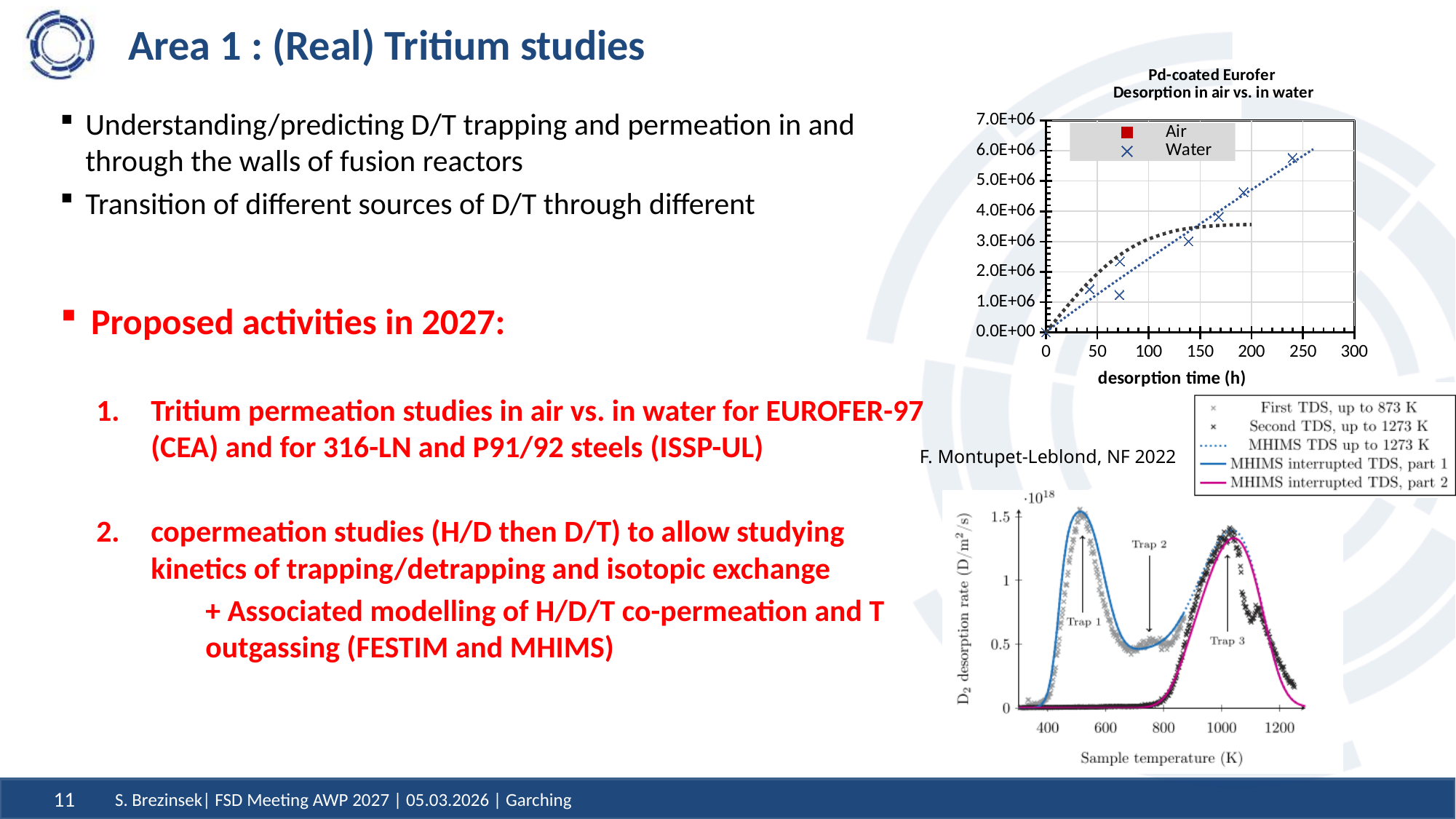
In the 'Pd-coated Eurofer Desorption in air vs. in water' chart, what is the label of the x axis? desorption time (h) In the bottom-right TDS chart, is the peak desorption rate at Trap 1 greater or less than 1 (×10^18 D/m²/s)? greater In the 'Pd-coated Eurofer Desorption in air vs. in water' chart, is the Water value at about 70 h greater or less than 2.0E+06? less In the 'Pd-coated Eurofer Desorption in air vs. in water' chart, what are the two series named in the legend? Air and Water In the 'Pd-coated Eurofer Desorption in air vs. in water' chart, around 50 h, which series shows the higher value, Air or Water? Air In the 'Pd-coated Eurofer Desorption in air vs. in water' chart, is the Water value at about 240 h greater or less than 5.0E+06? greater In the 'Pd-coated Eurofer Desorption in air vs. in water' chart, how many series does the legend list? 2 In the bottom-right TDS chart, which peak is higher, Trap 1 or Trap 3? Trap 1 In the 'Pd-coated Eurofer Desorption in air vs. in water' chart, do the Water values rise or fall as desorption time increases? rise What kind of chart is the 'Pd-coated Eurofer Desorption in air vs. in water' chart? scatter chart In the bottom-right TDS chart, how many entries does the legend list? 5